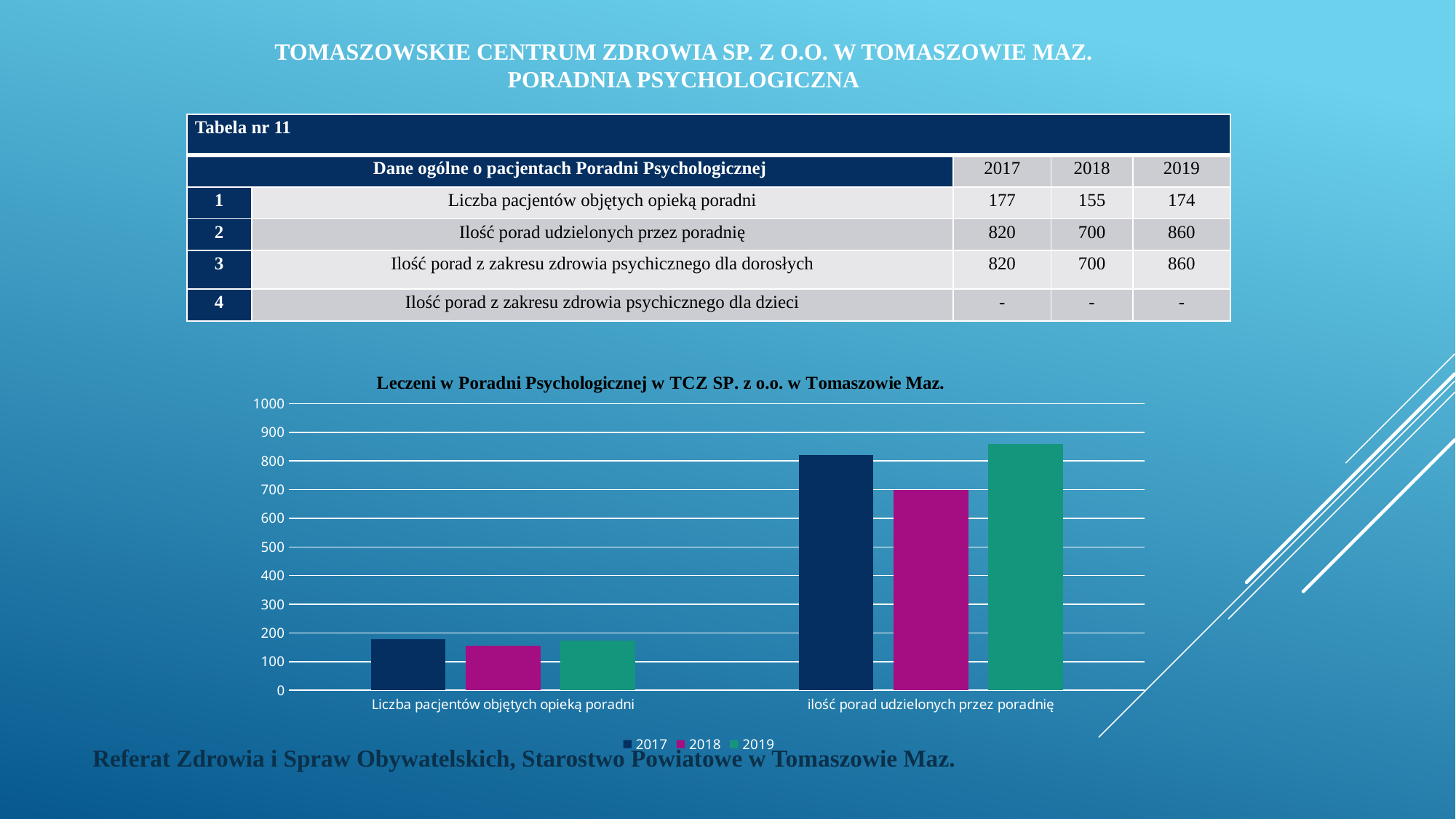
Is the 2018 value for 'ilość porad udzielonych przez poradnię' greater or less than 800? less What is the value of the 2018 bar for 'ilość porad udzielonych przez poradnię'? 700 Which year has the lowest bar for 'Liczba pacjentów objętych opieką poradni'? 2018 Which is larger: the 2017 bar or the 2019 bar for 'ilość porad udzielonych przez poradnię'? 2019 Is the 2017 value for 'Liczba pacjentów objętych opieką poradni' greater or less than 200? less Is the 2019 value for 'ilość porad udzielonych przez poradnię' greater or less than 800? greater How many categories are shown on the x axis of the chart? 2 Which year has the highest bar for 'ilość porad udzielonych przez poradnię'? 2019 Which year has the lowest bar for 'ilość porad udzielonych przez poradnię'? 2018 What is the title of the chart? Leczeni w Poradni Psychologicznej w TCZ SP. z o.o. w Tomaszowie Maz. What kind of chart is shown on the slide? bar chart How many series does the chart legend list? 3